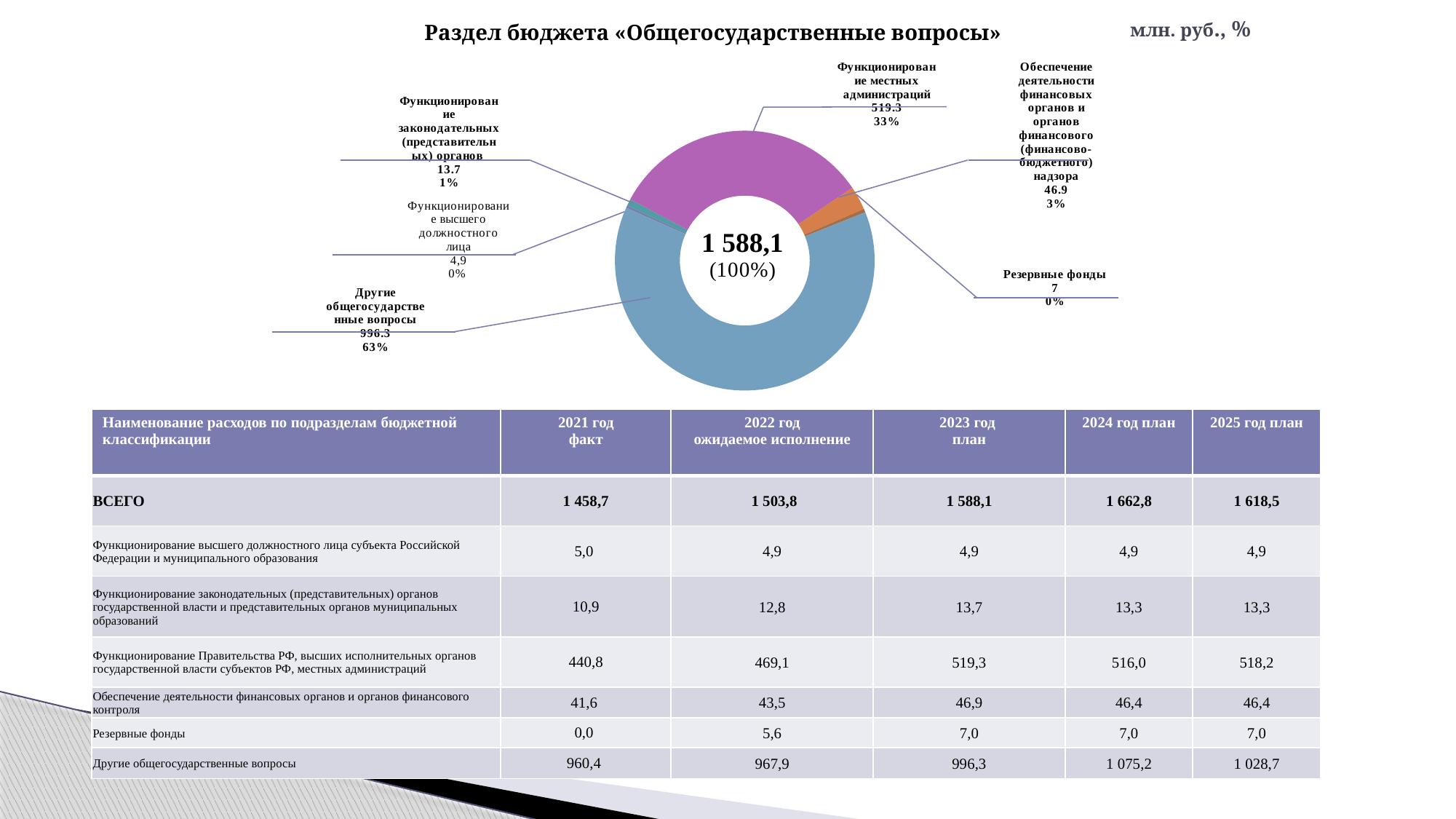
What is the value shown for «Другие общегосударственные вопросы» in the chart? 996.3 Which is larger: «Обеспечение деятельности финансовых органов» or «Функционирование законодательных (представительных) органов»? Обеспечение деятельности финансовых органов What is the value shown for «Резервные фонды» in the chart? 7 Which category has the largest slice in the chart? Другие общегосударственные вопросы What is the difference between the values for «Другие общегосударственные вопросы» and «Функционирование местных администраций»? 477 How many slices (categories) does the doughnut chart have? 6 Which category has the smallest value in the chart? Функционирование высшего должностного лица What is the value shown for «Функционирование местных администраций» in the chart? 519.3 What total value is shown in the centre of the doughnut chart? 1 588,1 What kind of chart is shown on the slide? Doughnut (pie) chart What share of the chart does «Функционирование местных администраций» represent? 33% What share of the chart does «Обеспечение деятельности финансовых органов и органов финансового (финансово-бюджетного) надзора» represent? 3%